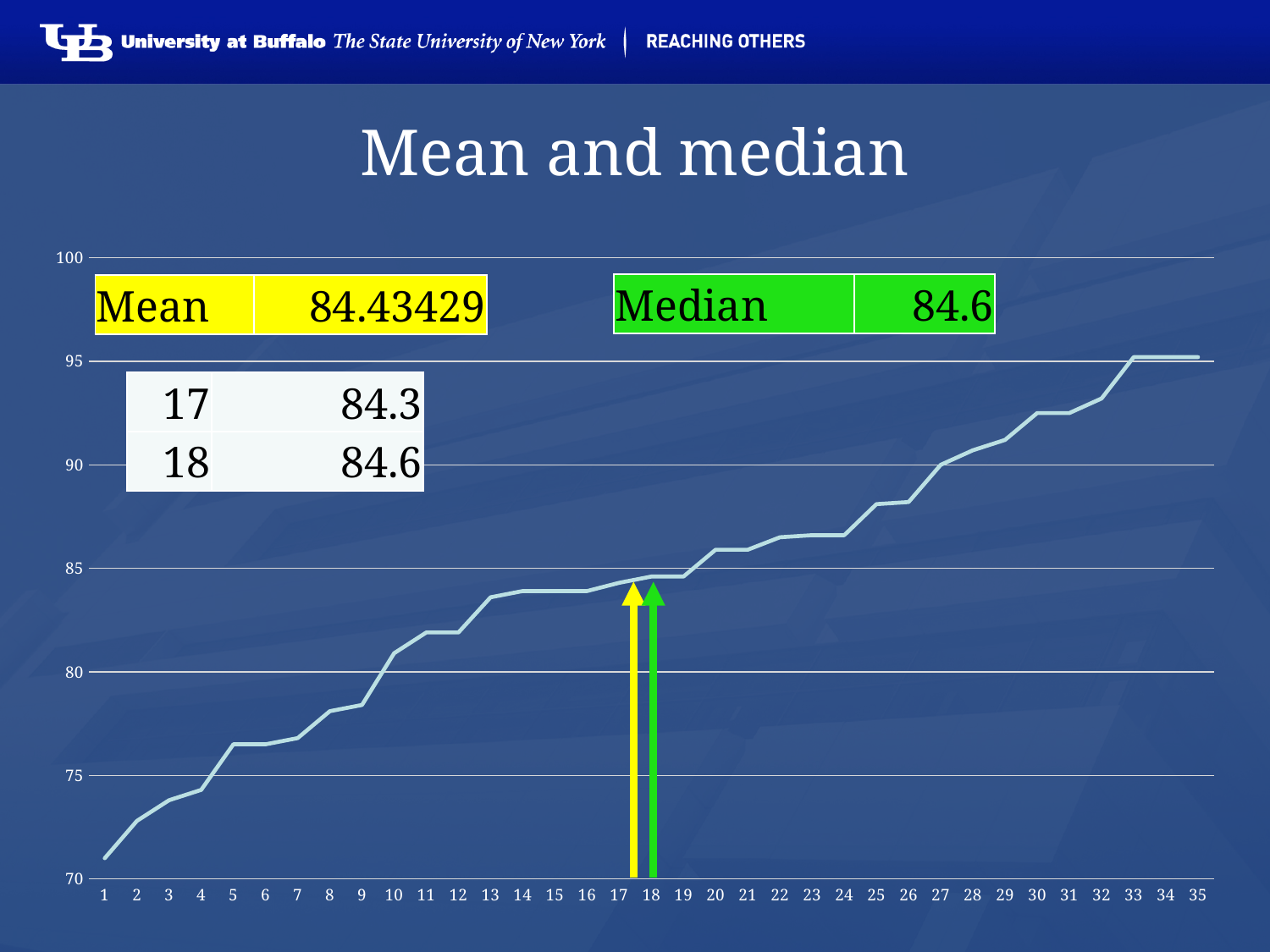
Is the value for point 27 greater or less than 85? greater What is the difference between the values for points 18 and 17? 0.3 What kind of chart is shown on the slide? line chart Is the value for point 1 greater or less than 75? less Is the value for point 24 greater or less than 90? less Do the values rise or fall as you move from point 1 to point 35? rise What is the value for point 17? 84.3 What mean value is shown in the yellow box? 84.43429 What is the value for point 18? 84.6 Which point has the lowest value? 1 How many points are plotted along the x axis? 35 What is the title of the slide? Mean and median